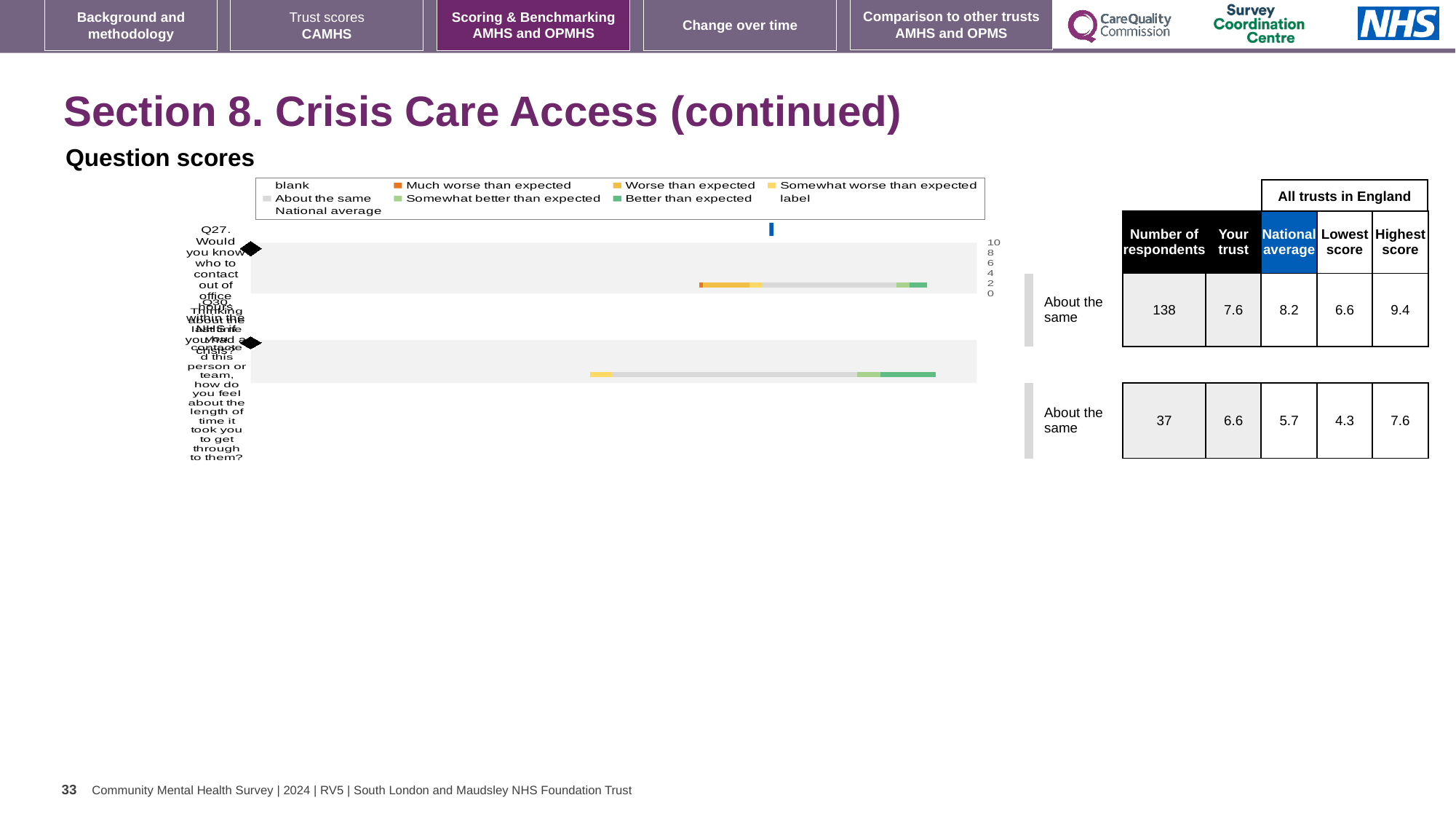
In the table next to the chart, what is the highest score for the first question row (Q27)? 9.4 In the table next to the chart, what is the national average for the second question row (Q30)? 5.7 What kind of chart is shown under 'Question scores'? bar chart How many question rows (categories) are plotted in the chart? 2 In the table next to the chart, what is the lowest score for the second question row (Q30)? 4.3 How many entries does the chart legend list? 9 In the table next to the chart, which question row has more respondents, the first (Q27) or the second (Q30)? the first (Q27) In the table next to the chart, what is the number of respondents for the first question row (Q27)? 138 Which legend entry is shown in orange? Much worse than expected Which legend entry is shown in dark green? Better than expected In the table next to the chart, what is the 'Your trust' score for the first question row (Q27)? 7.6 In the table next to the chart, what is the difference between the 'Your trust' score and the national average for the second question row (Q30)? 0.9